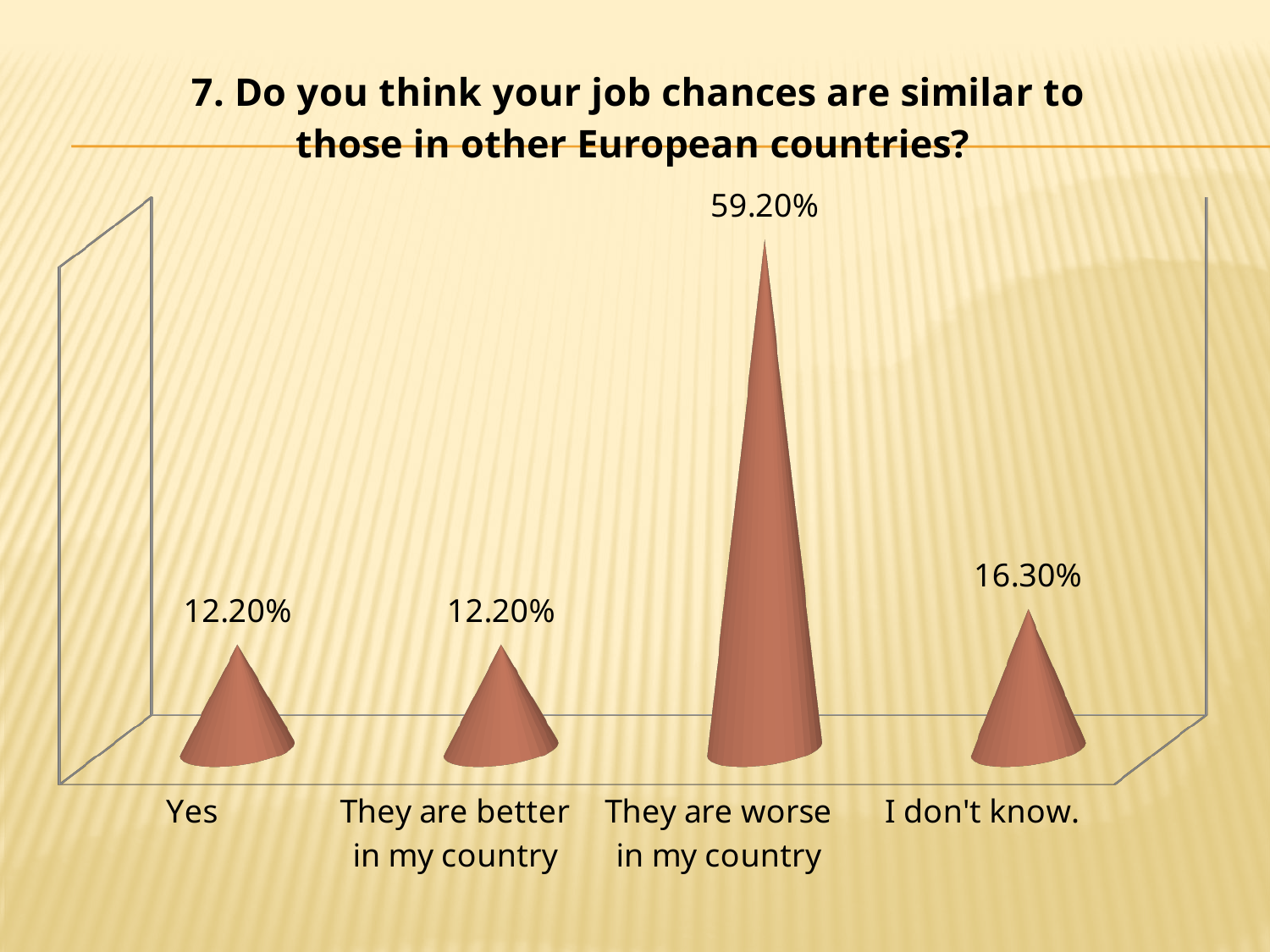
What is the difference between "I don't know." and "Yes"? 4.10% What is the difference between "They are worse in my country" and "I don't know."? 42.90% Which category has the highest value? They are worse in my country What kind of chart is shown on the slide? Bar chart What is the value for "Yes"? 12.20% What is the value for "They are worse in my country"? 59.20% What is the value for "I don't know."? 16.30% Which is larger, the value for "I don't know." or the value for "Yes"? I don't know. What is the value for "They are better in my country"? 12.20% What is the title of the chart? 7. Do you think your job chances are similar to those in other European countries? How many categories are shown on the chart? 4 Which is larger, the value for "They are worse in my country" or the value for "They are better in my country"? They are worse in my country